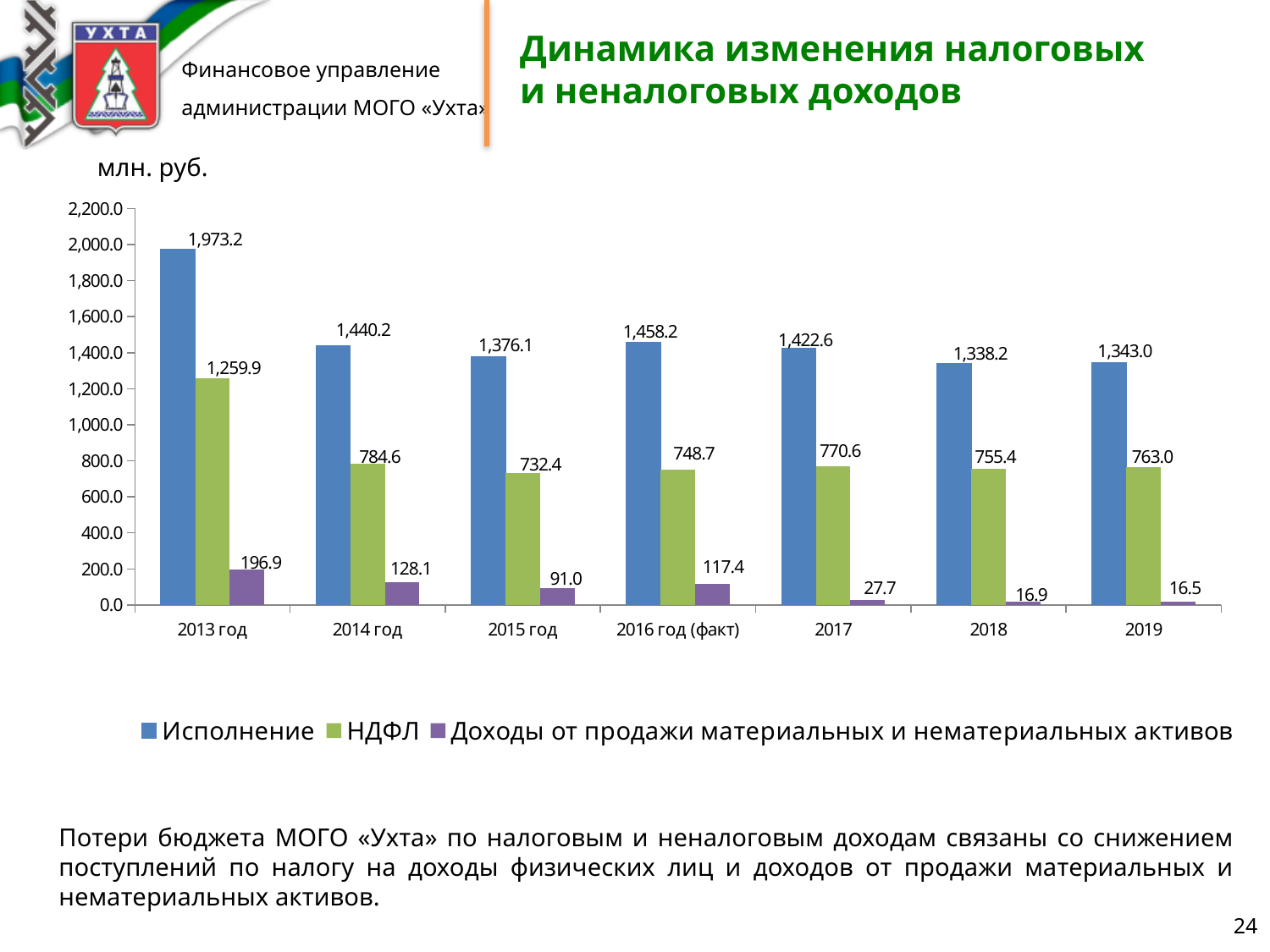
What is the value of Исполнение for 2013 год? 1,973.2 What is the difference between Исполнение in 2013 год and in 2014 год? 533.0 What kind of chart is shown on the slide? bar chart What unit is indicated above the chart? млн. руб. Is the value of Исполнение for 2015 год greater or less than 1,400.0? less What is the value of Доходы от продажи материальных и нематериальных активов for 2019? 16.5 In which year is Исполнение the highest? 2013 год How many series does the legend list? 3 What is the value of НДФЛ for 2016 год (факт)? 748.7 Which is larger: НДФЛ in 2017 or НДФЛ in 2018? 2017 In which year is Доходы от продажи материальных и нематериальных активов the lowest? 2019 How many years are shown on the x axis? 7